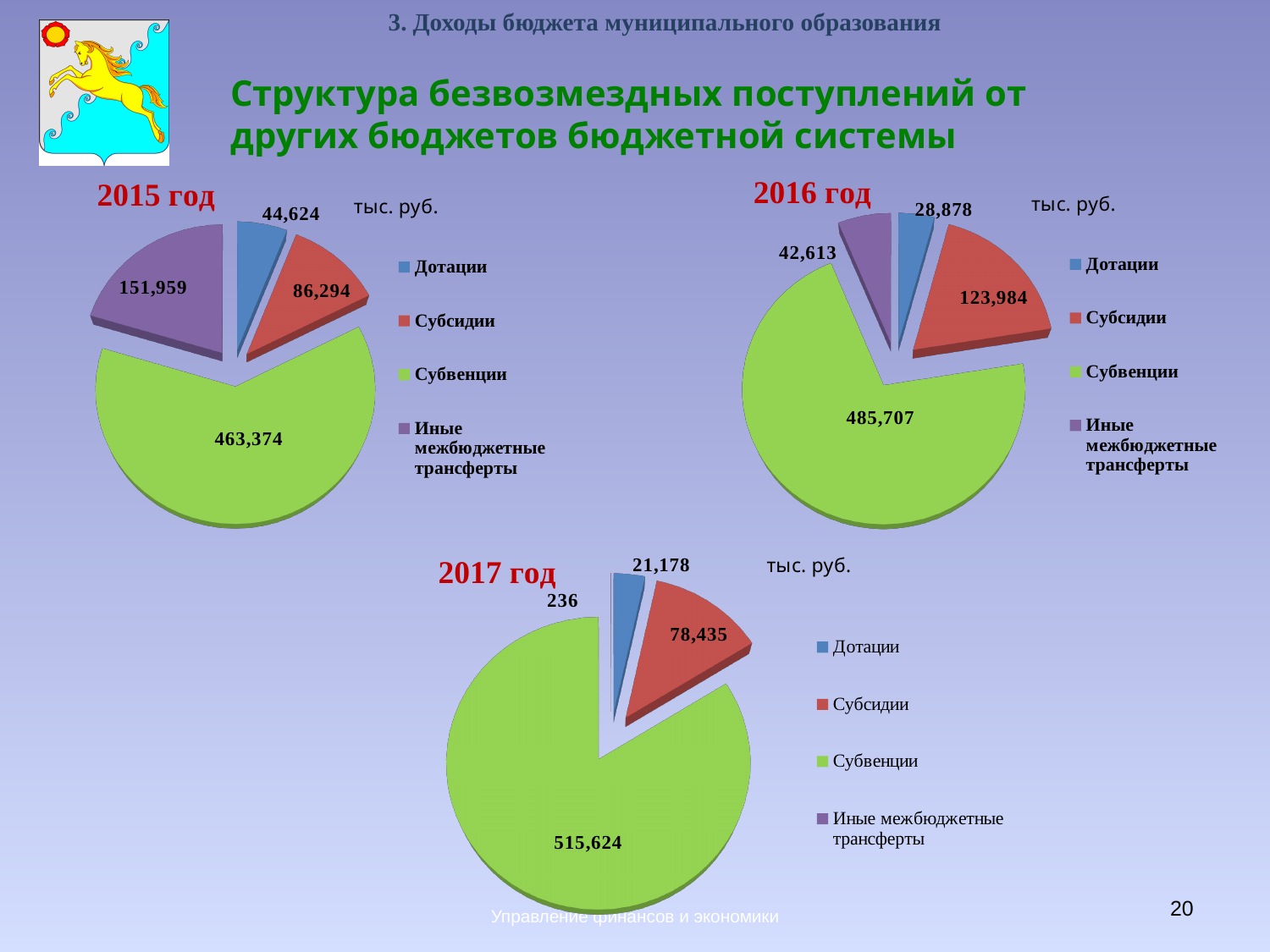
In the 2017 год chart, which category has the largest value? Субвенции In the 2016 год chart, which category has the smallest value? Дотации In the 2015 год chart, what colour is the Субвенции slice? green In the 2016 год chart, what is the difference between Субсидии and Дотации? 95,106 In the 2015 год chart, what is the difference between Субвенции and Иные межбюджетные трансферты? 311,415 In the 2016 год chart, what is the value for Субсидии? 123,984 What kind of chart is used for the 2015 год data? pie chart In the 2017 год chart, which is larger, Дотации or Субсидии? Субсидии In the 2017 год chart, what is the value for Иные межбюджетные трансферты? 236 In the 2015 год chart, what is the value for Субвенции? 463,374 How many categories does the legend of the 2016 год chart list? 4 In the 2015 год chart, what is the value for Иные межбюджетные трансферты? 151,959